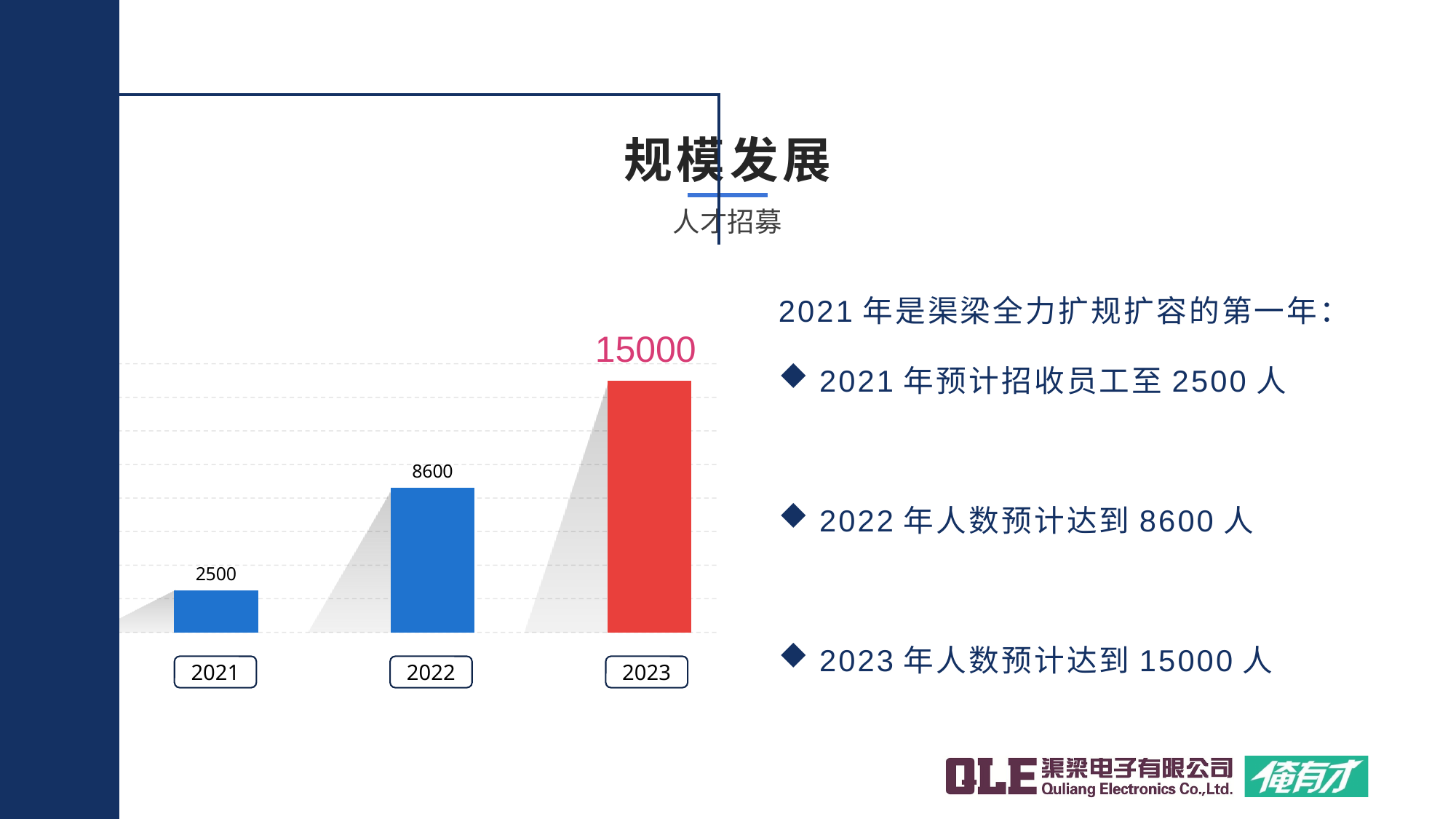
What kind of chart is shown? bar chart What is the difference between the values for 2022 and 2021? 6100 What is the value shown for 2021? 2500 Which year has the lowest value? 2021 Do the values rise or fall from 2021 to 2023? rise Which year has the highest value? 2023 What is the difference between the values for 2023 and 2022? 6400 How many years are shown on the x axis? 3 What is the value shown for 2022? 8600 Which is larger, the value for 2022 or the value for 2021? 2022 What colour is the bar for 2023? red What is the value shown for 2023? 15000